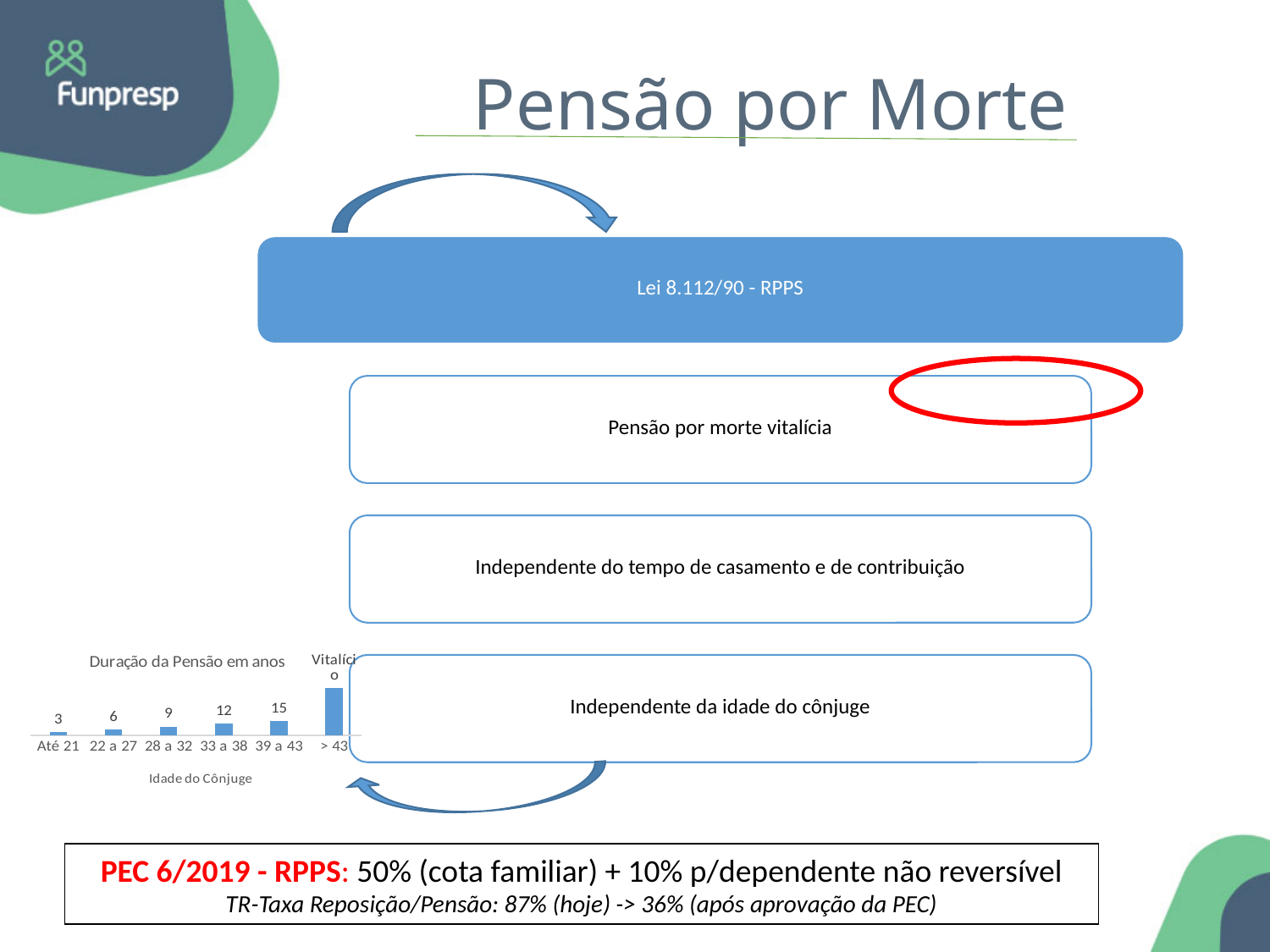
What is the x-axis title of the chart? Idade do Cônjuge What label is shown on the bar for the category '> 43'? Vitalício What is the difference between the pension duration for '39 a 43' and for '22 a 27'? 9 What is the pension duration value for the category 'Até 21'? 3 How many categories are shown on the x axis of the chart? 6 What type of chart is shown on the slide? bar chart What is the title of the chart on the slide? Duração da Pensão em anos What is the pension duration value for the category '33 a 38'? 12 What is the pension duration value for the category '28 a 32'? 9 What is the pension duration value for the category '39 a 43'? 15 What is the pension duration value for the category '22 a 27'? 6 Which category has the lowest pension duration in the chart? Até 21